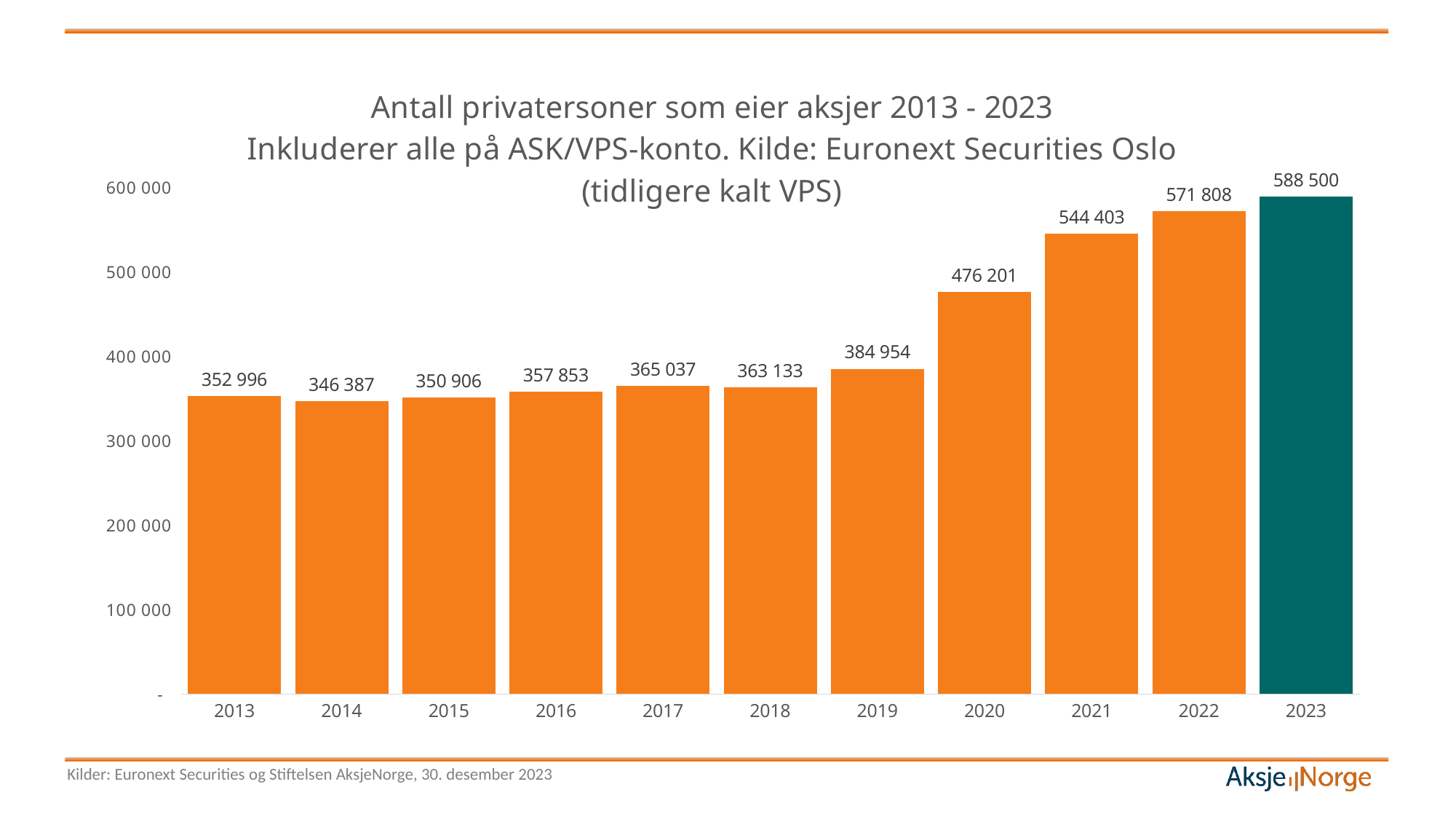
What is the value for 2023? 588 500 Is the value for 2021 greater or less than 500 000? greater What is the difference between the values for 2023 and 2022? 16 692 Which is larger, the value for 2017 or the value for 2018? 2017 What is the value for 2020? 476 201 Which year has the lowest value? 2014 How many years are shown on the x axis? 11 Which bar is shown in a different colour from the others? 2023 What is the difference between the values for 2020 and 2019? 91 247 What kind of chart is this? bar chart Which year has the highest value? 2023 What is the value for 2013? 352 996